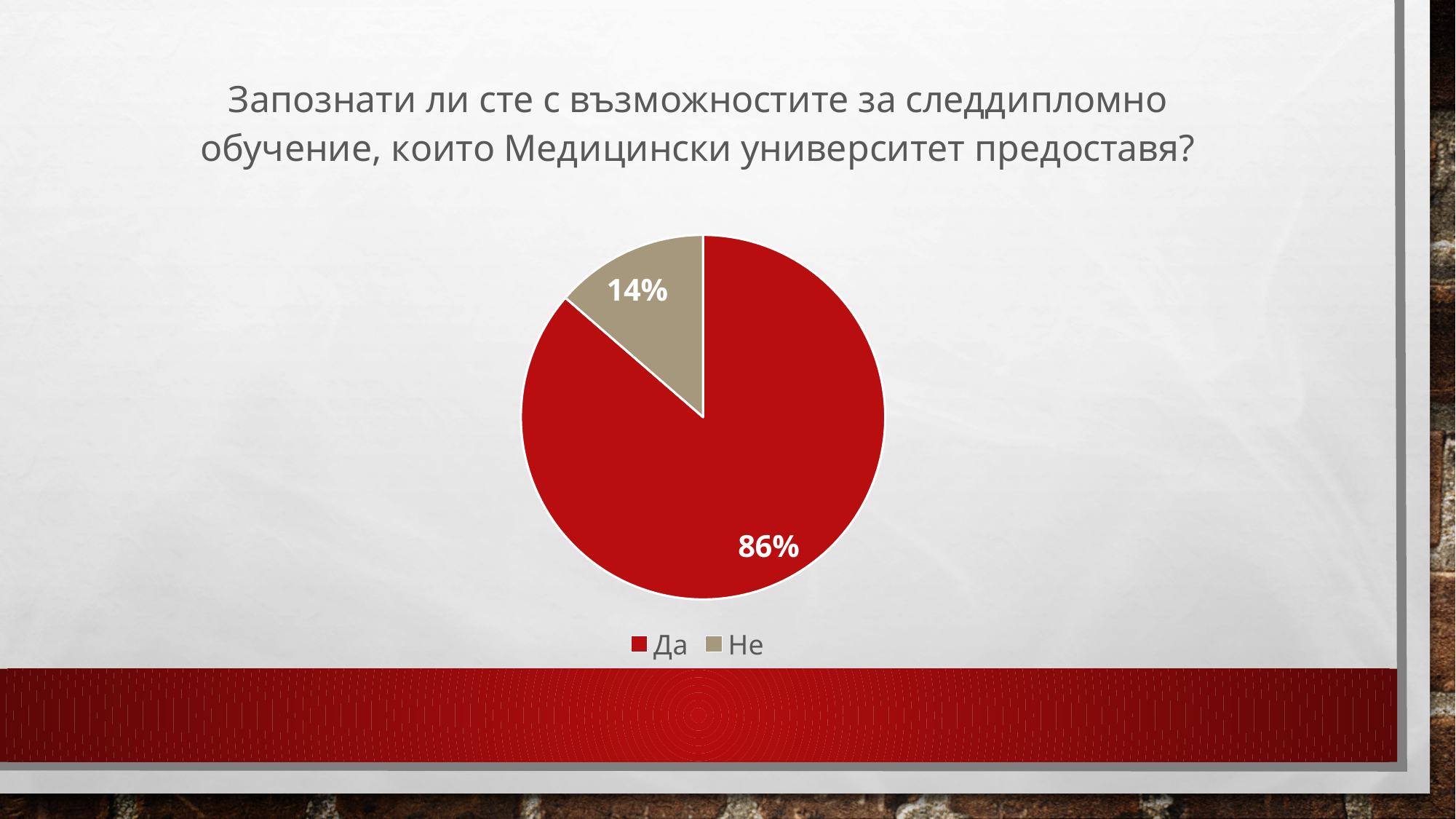
Which answer has the smallest share of the pie? Не What colour is the "Не" slice? Beige What percentage of respondents answered "Не"? 14% What share of the pie does the "Не" slice represent? 14% How many entries does the legend list? 2 What percentage of respondents answered "Да"? 86% What colour is the "Да" slice? Red What kind of chart is shown on the slide? Pie chart What is the difference in percentage points between the "Да" and "Не" slices? 72 Which answer has the largest share of the pie? Да Which slice is larger, "Да" or "Не"? Да How many slices does the pie chart have? 2